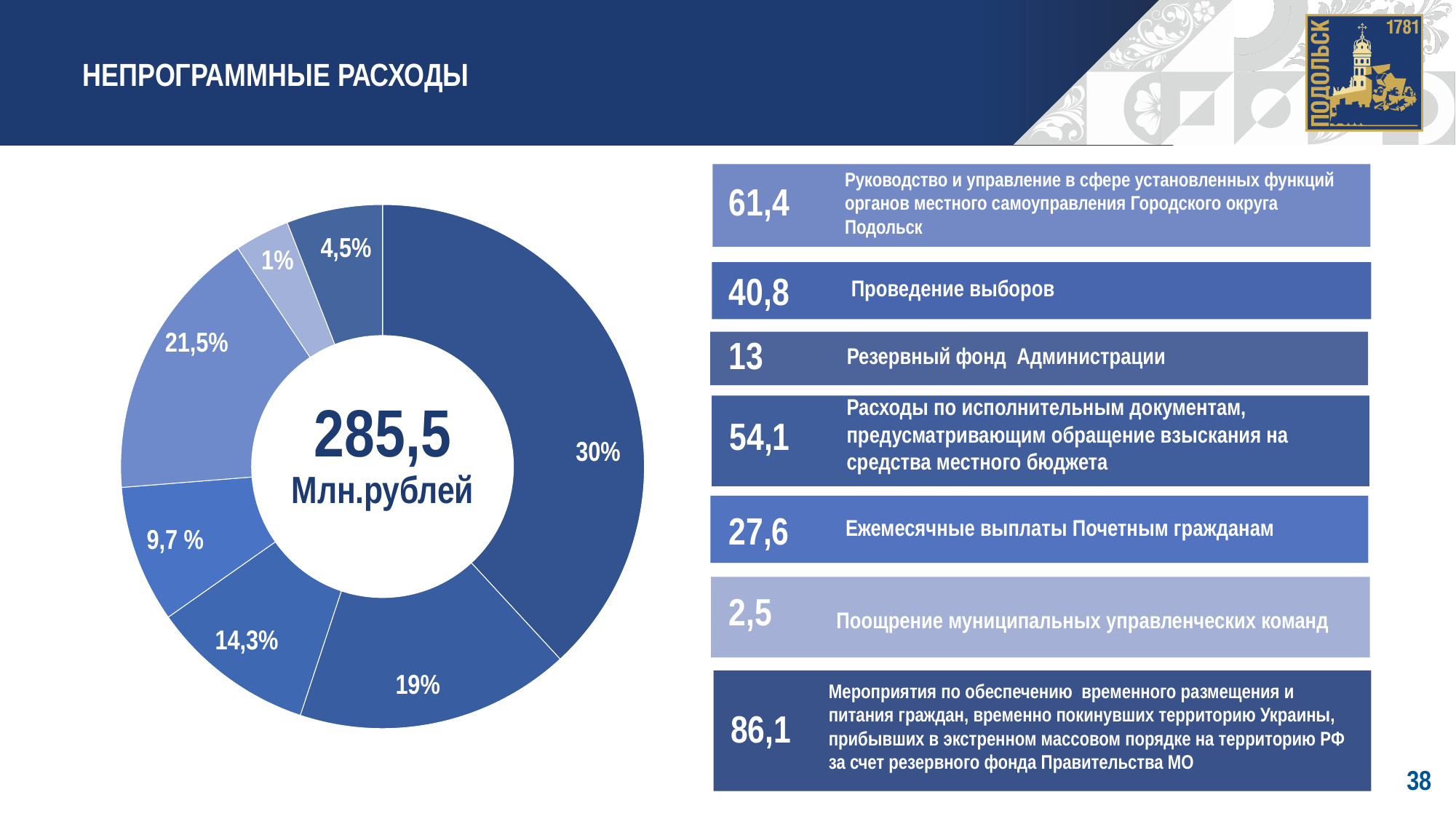
What total value is printed in the centre of the donut chart? 285,5 Млн.рублей What is the percentage of the largest slice in the donut chart? 30% How many slices does the donut chart have? 7 What value is shown for 'Резервный фонд Администрации'? 13 What value is shown for 'Проведение выборов' in the list on the right? 40,8 Which is larger: the value for 'Расходы по исполнительным документам' or for 'Проведение выборов'? Расходы по исполнительным документам (54,1) Which item in the list on the right has the lowest value? Поощрение муниципальных управленческих команд (2,5) What kind of chart is shown on the slide? Pie (donut) chart Which item in the list on the right has the highest value? Мероприятия по обеспечению временного размещения и питания граждан, временно покинувших территорию Украины (86,1) What is the percentage of the smallest slice in the donut chart? 1% What is the difference between the value for 'Руководство и управление в сфере установленных функций органов местного самоуправления' (61,4) and 'Проведение выборов' (40,8)? 20,6 What value is shown for 'Ежемесячные выплаты Почетным гражданам'? 27,6